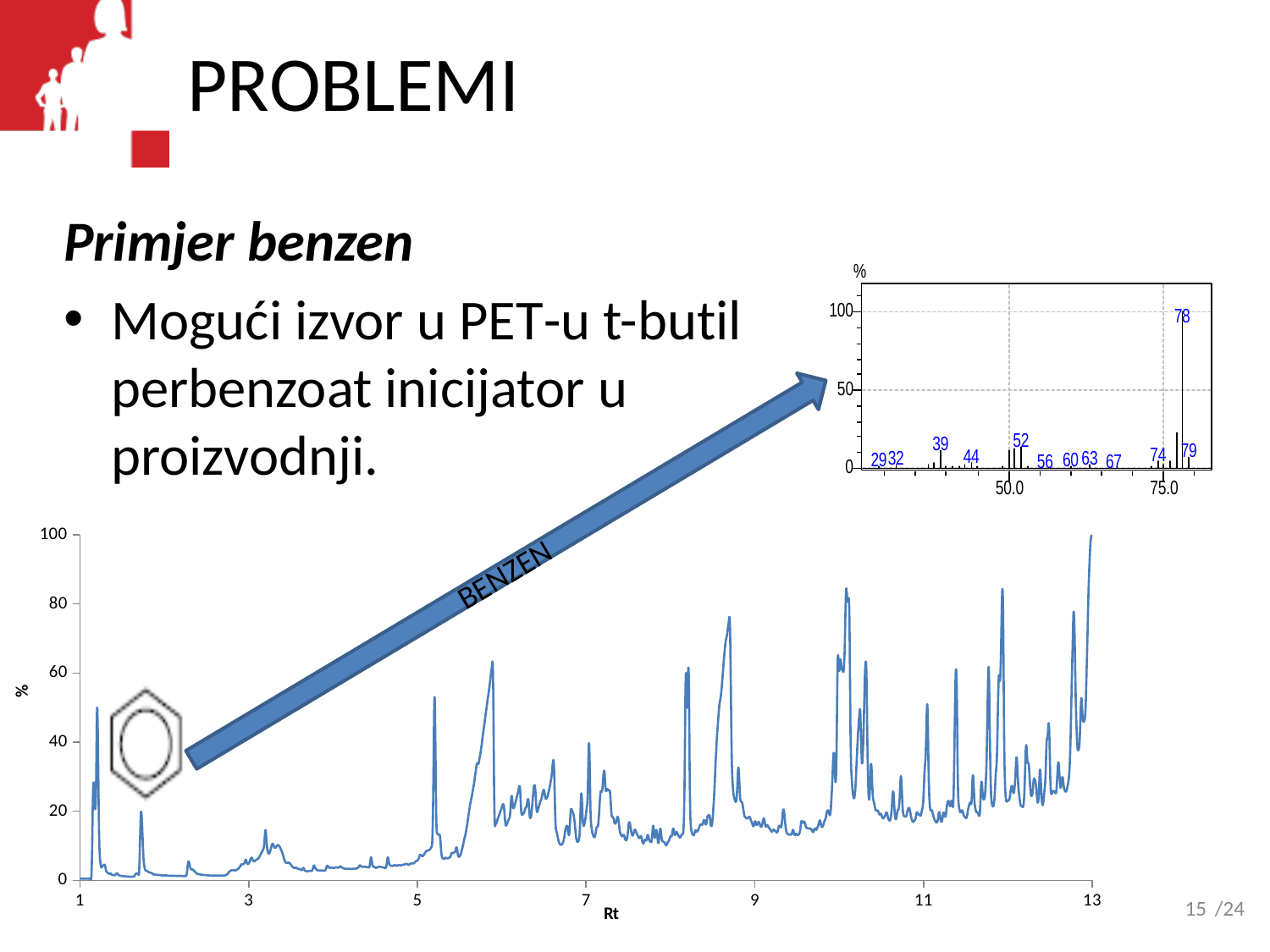
On the mass spectrum chart at the top right, which labelled m/z peak is the highest? 78 On the mass spectrum chart at the top right, which peak is larger, 78 or 52? 78 On the mass spectrum chart at the top right, what is the value (%) of the peak labelled 78? 100 On the mass spectrum chart at the top right, is the value for the peak labelled 79 greater or less than 50? less On the bottom chart, is the first peak just after Rt 1 greater or less than 40%? greater What kind of chart is the large chart at the bottom of the slide (with the Rt axis)? line chart On the bottom chart, what is the label of the x axis? Rt On the bottom chart, what is the highest value shown on the y axis? 100 On the bottom chart, is the peak near Rt 1.7 greater or less than 40%? less How many labelled m/z peaks are shown on the mass spectrum chart at the top right? 12